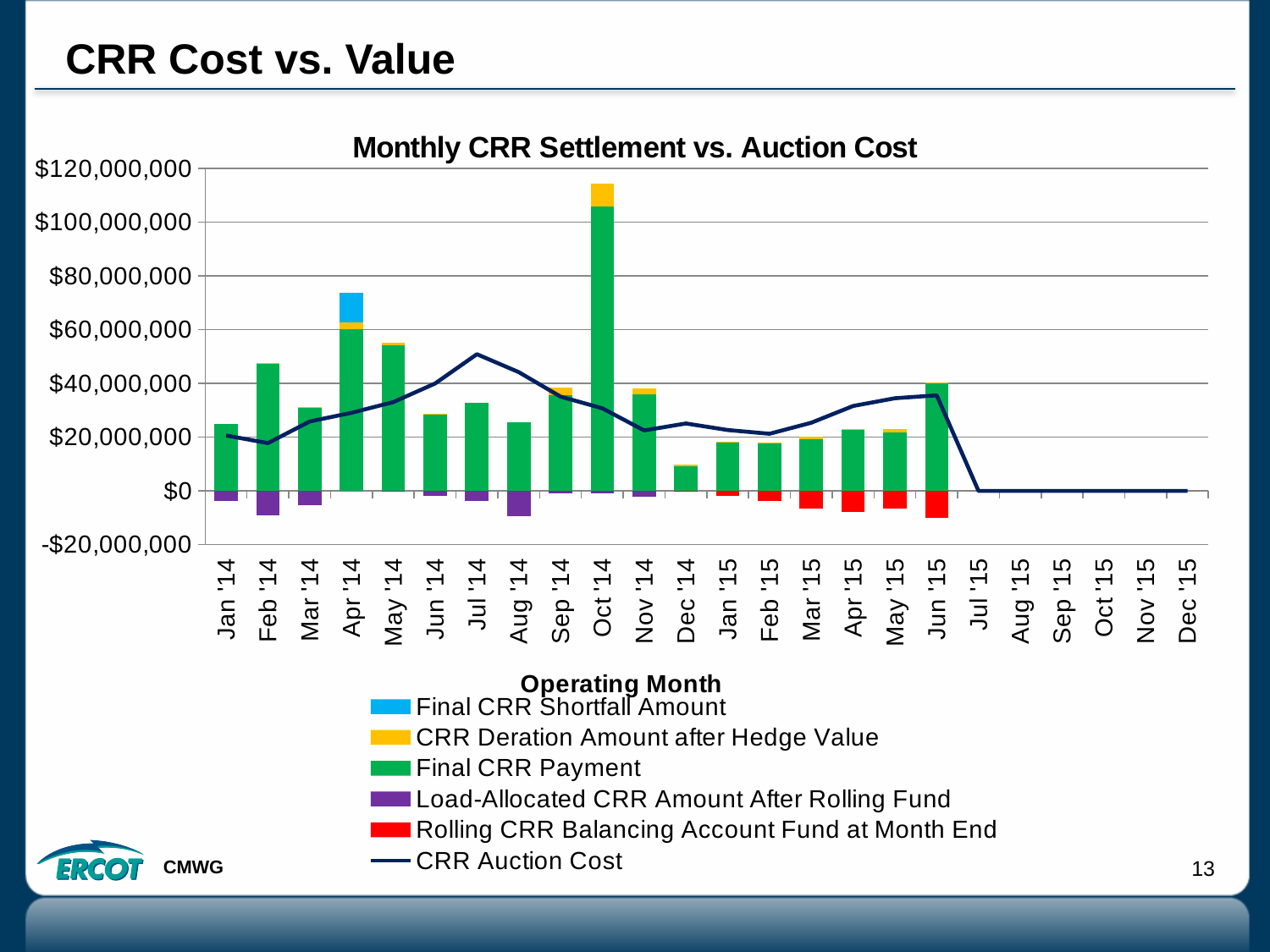
What is the title of the chart? Monthly CRR Settlement vs. Auction Cost Does the CRR Auction Cost line rise or fall from Jan '14 to Jul '14? rise Is the CRR Auction Cost for Jul '14 greater or less than $40,000,000? greater Which has the larger Final CRR Payment, Feb '14 or Mar '14? Feb '14 Is the Final CRR Payment for Feb '14 greater or less than $40,000,000? greater How many operating months are shown on the x axis? 24 What is the CRR Auction Cost for Dec '15? $0 What kind of chart is shown on the slide? combination bar and line chart How many series does the legend list? 6 Which operating month has the highest Final CRR Payment? Oct '14 Is the Final CRR Payment for Dec '14 greater or less than $20,000,000? less